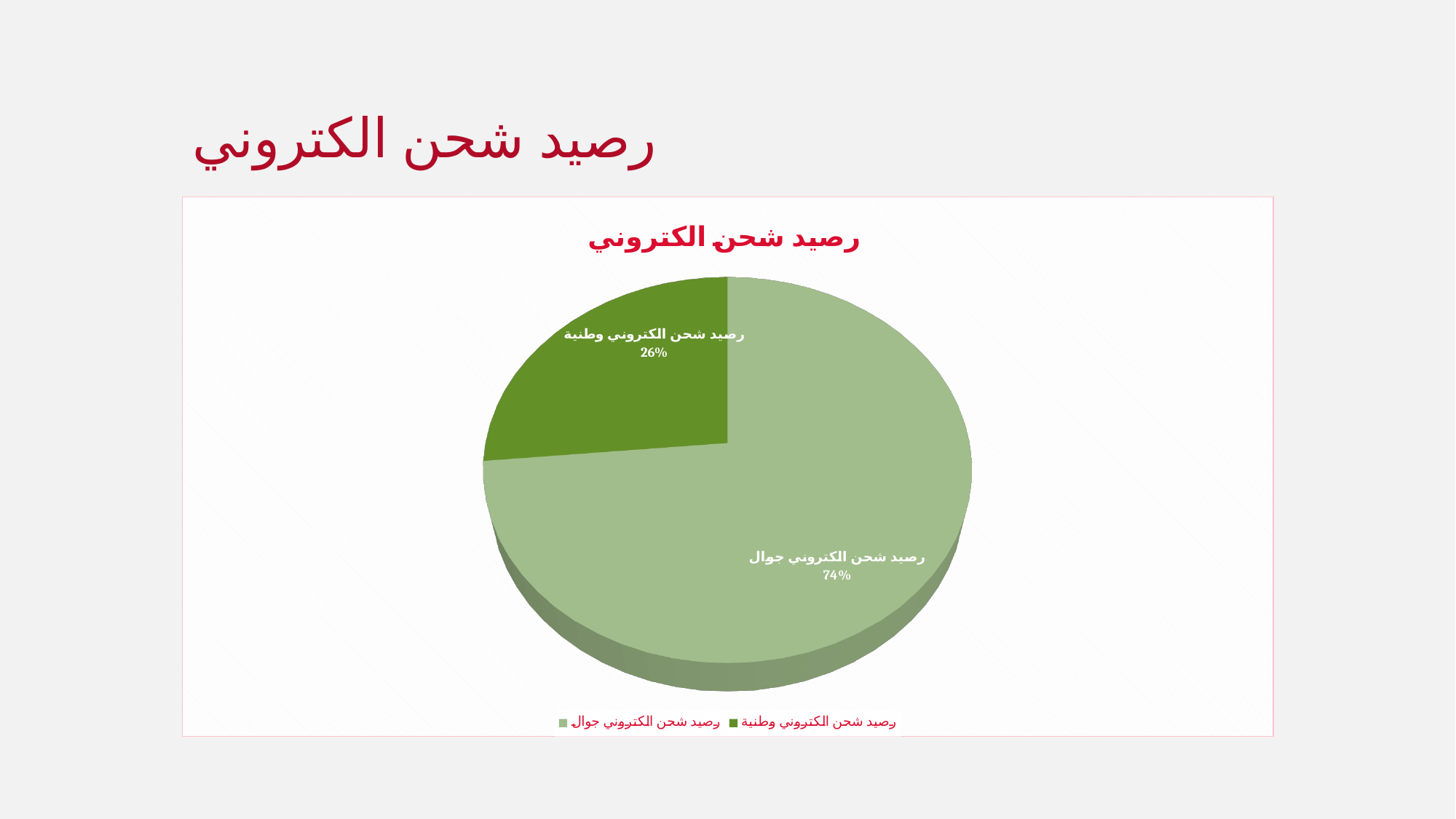
What is the title of the chart? رصيد شحن الكتروني How many entries does the legend list? 2 Which slice is shown in the darker green colour? رصيد شحن الكتروني وطنية Which slice is the smallest in the pie chart? رصيد شحن الكتروني وطنية What share of the pie does رصيد شحن الكتروني وطنية represent? 26% How many slices does the pie chart have? 2 Which is larger, the share for رصيد شحن الكتروني جوال or the share for رصيد شحن الكتروني وطنية? رصيد شحن الكتروني جوال What share of the pie does رصيد شحن الكتروني جوال represent? 74% What type of chart is shown on the slide? Pie chart What is the difference in percentage points between the جوال slice and the وطنية slice? 48 Which slice is the largest in the pie chart? رصيد شحن الكتروني جوال